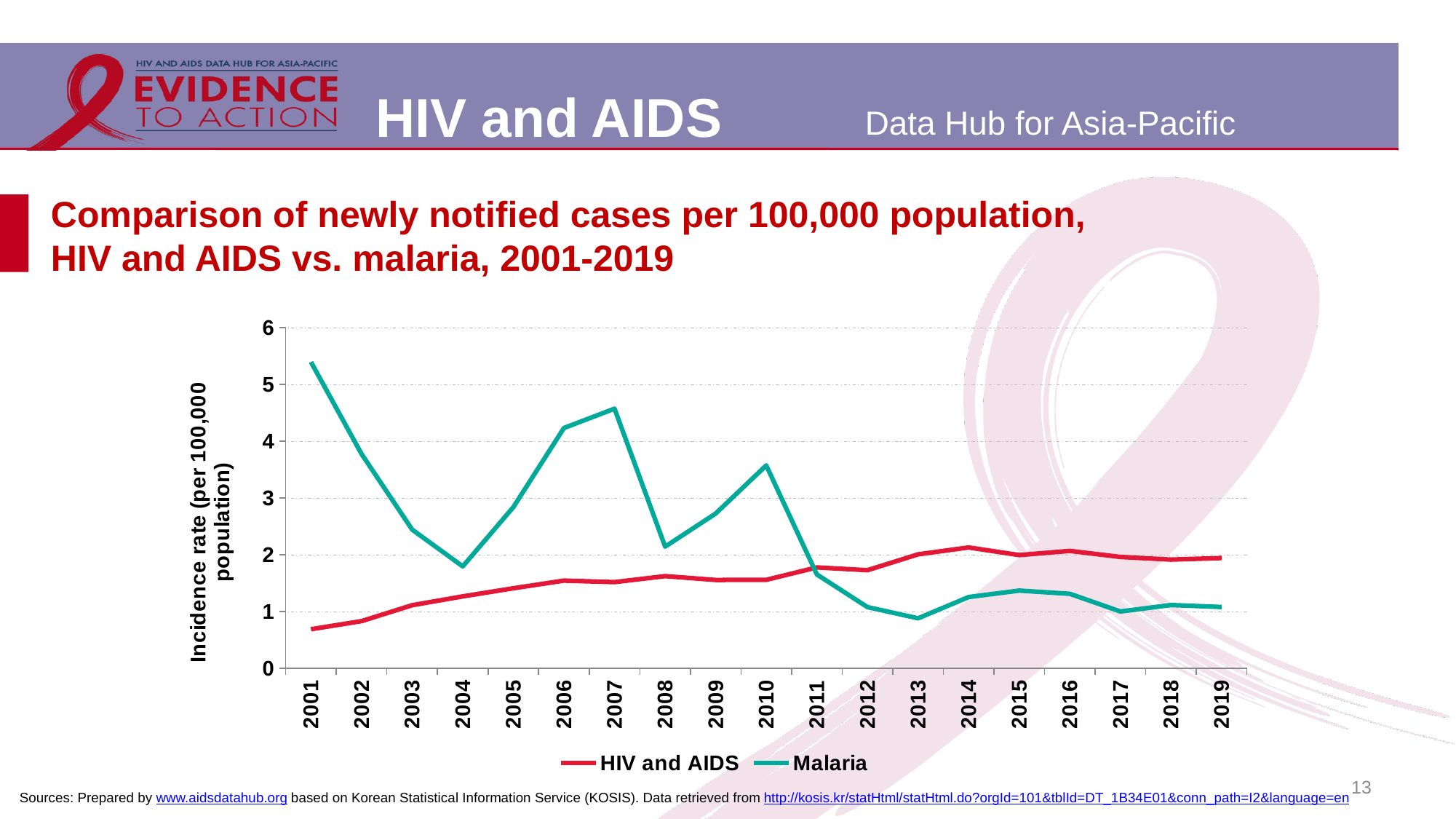
In which year is the HIV and AIDS incidence rate lowest? 2001 Is the HIV and AIDS value for 2001 greater or less than 1? less Is the Malaria value for 2007 greater or less than 4? greater Is the Malaria value for 2001 greater or less than 5? greater In which year is the Malaria incidence rate highest? 2001 How many series does the legend list? 2 Overall, does the HIV and AIDS line rise or fall from 2001 to 2019? Rise In 2019, which series has the larger value, HIV and AIDS or Malaria? HIV and AIDS In 2001, which series has the larger value, HIV and AIDS or Malaria? Malaria What is the label on the y axis? Incidence rate (per 100,000 population) What kind of chart is shown on the slide? Line chart How many years are plotted along the x axis? 19